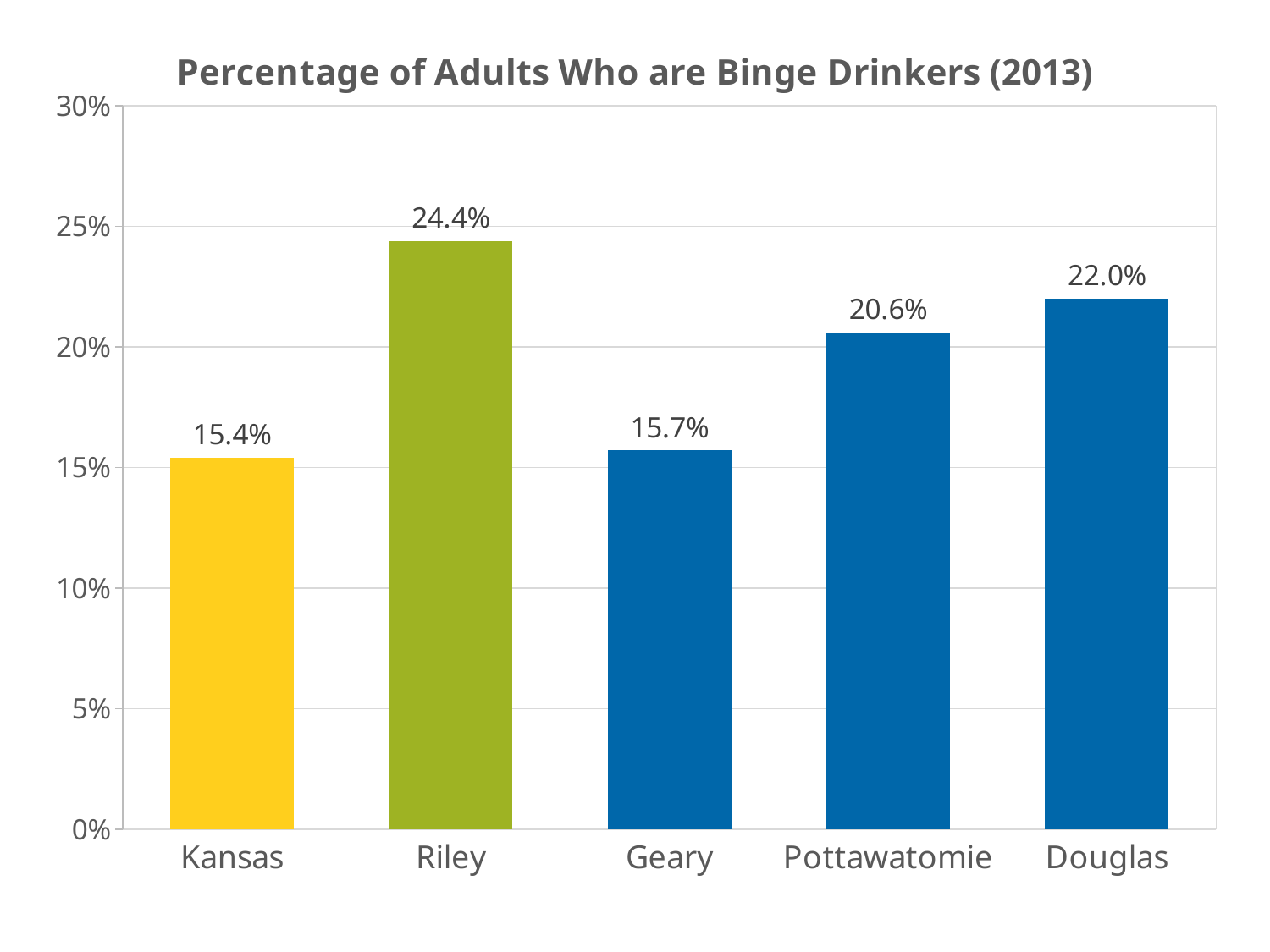
What is the difference between the values for Douglas and Geary? 6.3% What is the value shown for Kansas? 15.4% Which has a higher value, Douglas or Pottawatomie? Douglas Is the value for Geary greater or less than 20%? less Which category has the lowest percentage of binge drinkers? Kansas What is the title of the chart? Percentage of Adults Who are Binge Drinkers (2013) What is the value shown for Pottawatomie? 20.6% What is the difference between the values for Riley and Kansas? 9.0% What kind of chart is shown on the slide? Bar chart How many categories are shown on the chart? 5 Which category has the highest percentage of binge drinkers? Riley What is the percentage of adults who are binge drinkers in Riley? 24.4%